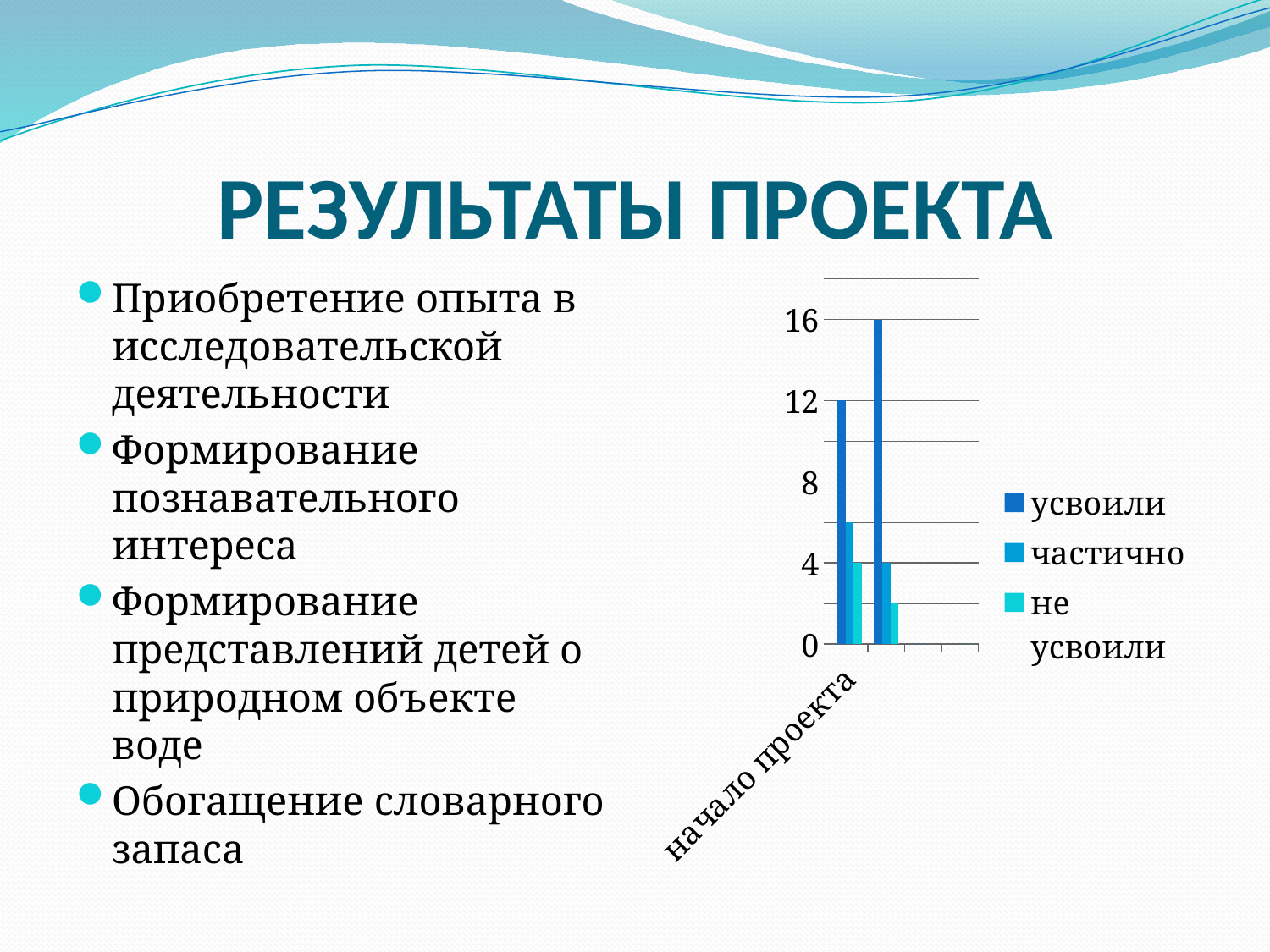
What is the value of the 'не усвоили' series for 'начало проекта'? 4 Is the value of the 'частично' series for 'начало проекта' greater or less than 4? greater Is the value of the 'частично' series for 'начало проекта' greater or less than 8? less For 'начало проекта', what is the difference between the 'усвоили' value and the 'не усвоили' value? 8 What are the three entries listed in the chart's legend? усвоили, частично, не усвоили How many series does the chart's legend list? 3 Which series has the highest value for 'начало проекта'? усвоили What is the value of the 'усвоили' series for 'начало проекта'? 12 What is the highest value labelled on the chart's vertical axis? 16 What kind of chart is shown on the slide? bar chart For 'начало проекта', which is larger: 'усвоили' or 'частично'? усвоили Which series has the lowest value for 'начало проекта'? не усвоили